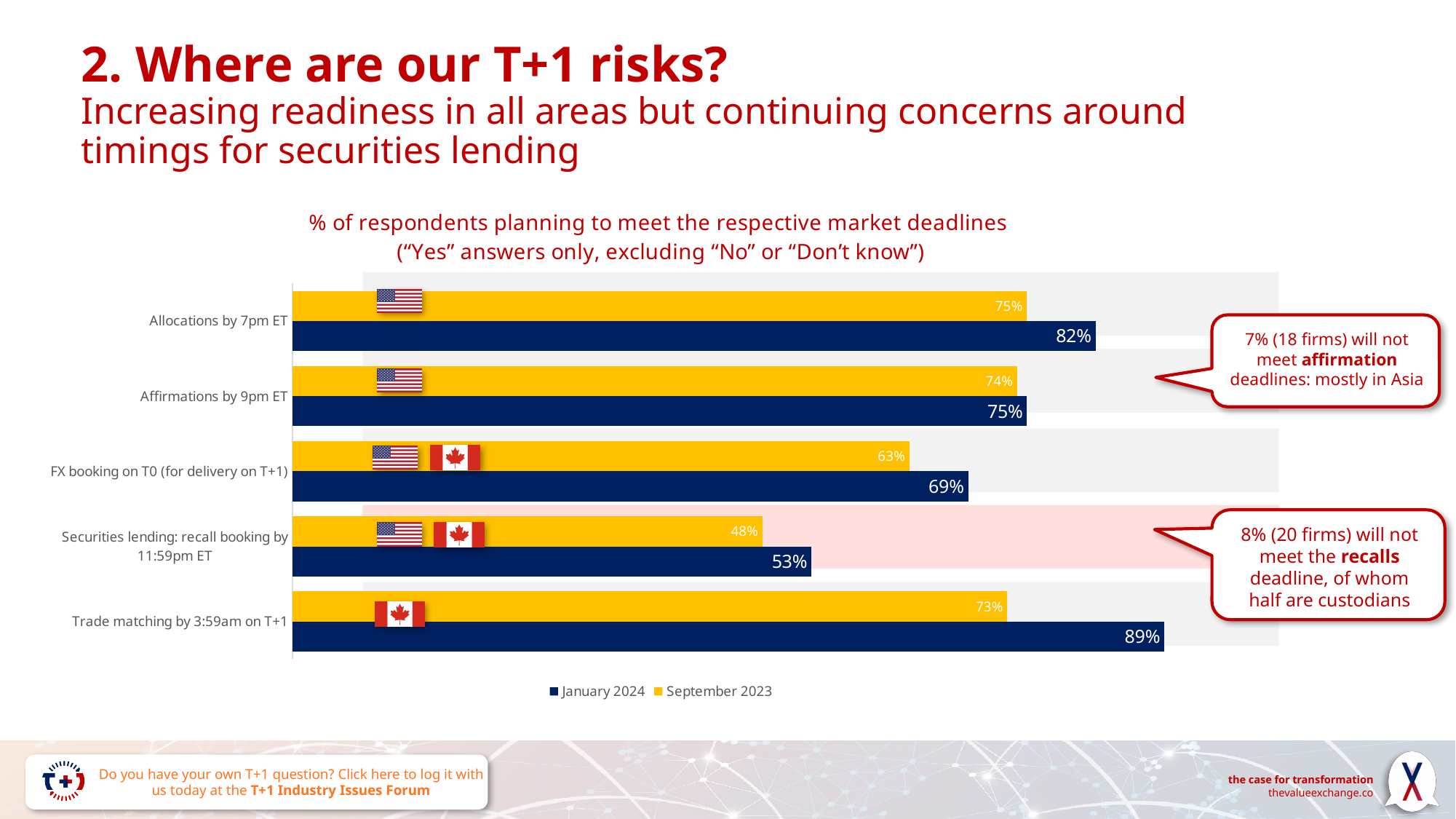
What is the January 2024 value for FX booking on T0 (for delivery on T+1)? 69% What is the January 2024 value for Allocations by 7pm ET? 82% What is the difference between the January 2024 and September 2023 values for Trade matching by 3:59am on T+1? 16% Which category has the lowest September 2023 value? Securities lending: recall booking by 11:59pm ET What is the difference between the January 2024 and September 2023 values for Affirmations by 9pm ET? 1% What is the September 2023 value for Securities lending: recall booking by 11:59pm ET? 48% How many categories are shown on the chart? 5 Which is larger: the January 2024 value for Allocations by 7pm ET or the January 2024 value for Affirmations by 9pm ET? Allocations by 7pm ET How many series does the legend list? 2 Which series is shown in yellow? September 2023 What kind of chart is shown on the slide? Bar chart Which category has the highest January 2024 value? Trade matching by 3:59am on T+1